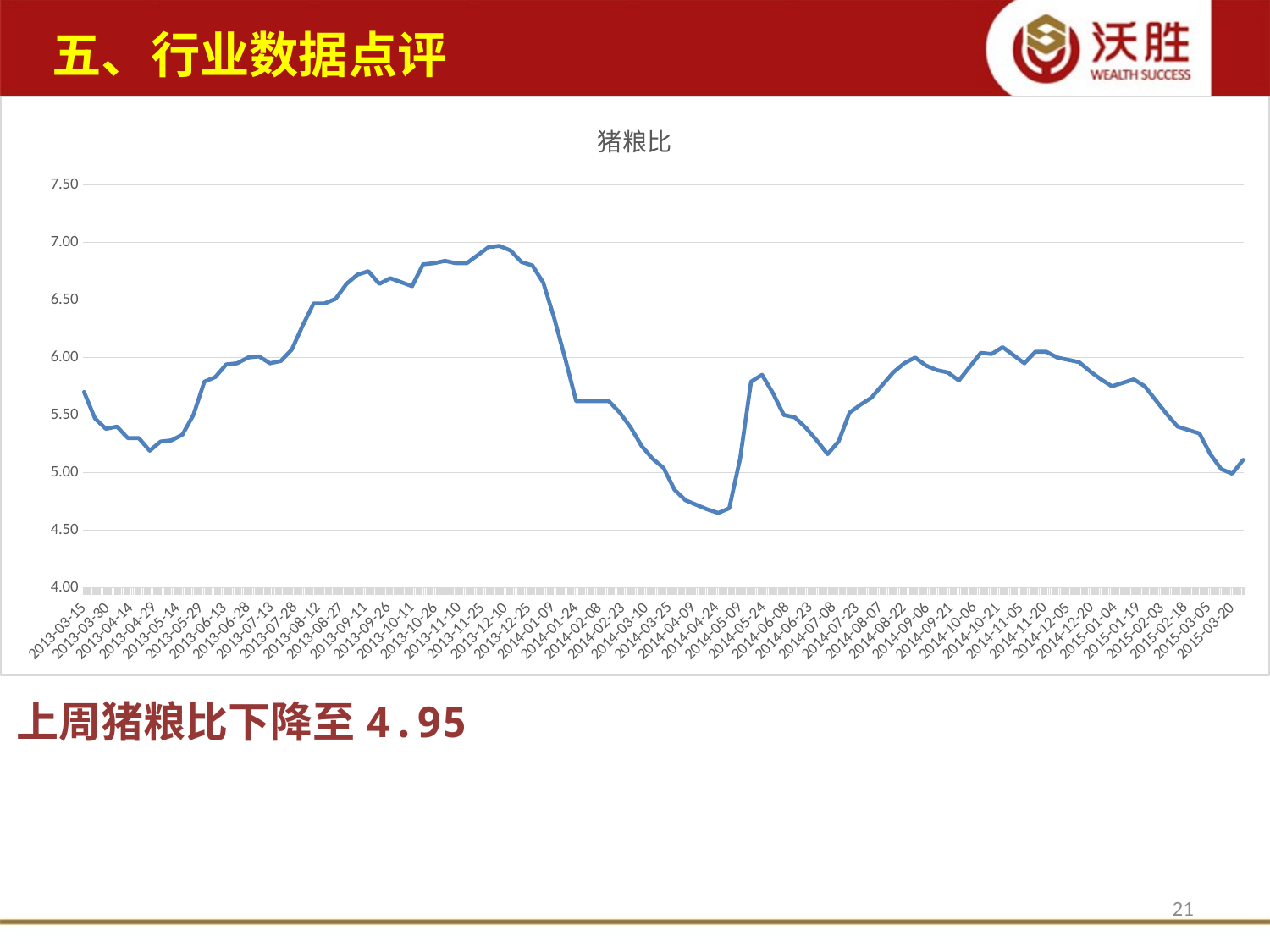
Is the value for 2013-12-10 greater or less than 6.50? greater Is the value for 2013-03-15 greater or less than 5.50? greater Is the value for 2014-07-08 greater or less than 5.50? less Does the line generally rise or fall between 2014-12-05 and 2015-03-05? fall Which is larger, the value for 2013-12-10 or the value for 2015-03-20? 2013-12-10 What is the title of the chart? 猪粮比 Which is larger, the value for 2013-03-15 or the value for 2014-04-24? 2013-03-15 Around which labeled date does the line reach its lowest value? 2014-04-24 What are the lowest and highest tick values on the vertical axis of the chart? 4.00 and 7.50 What kind of chart is shown on the slide? line chart